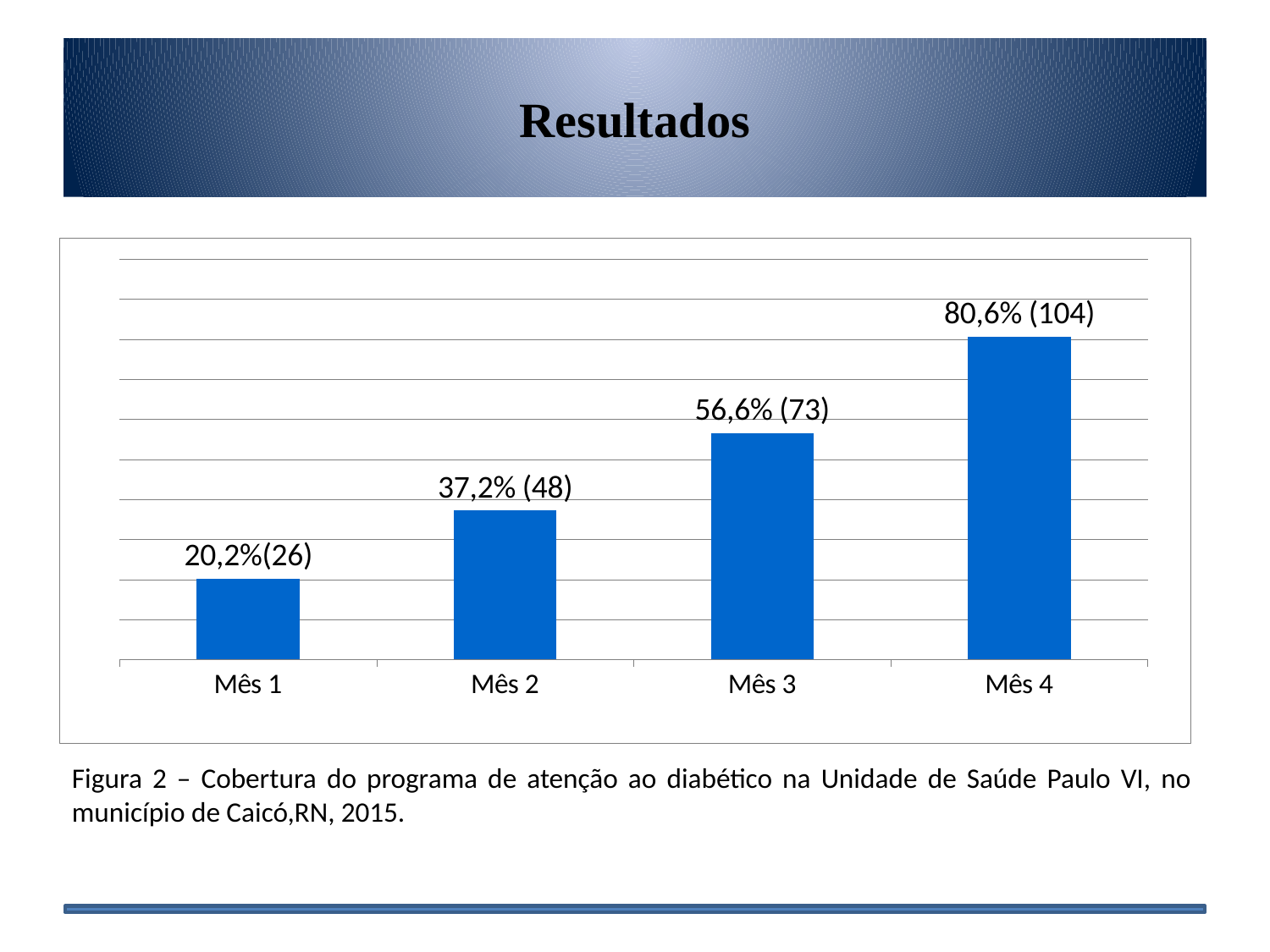
What is the difference in the number of cases (in parentheses) between Mês 4 and Mês 3? 31 Which is larger, the value for Mês 2 or the value for Mês 3? Mês 3 What percentage is shown for Mês 4? 80,6% Which month has the highest value? Mês 4 What is the data label shown for Mês 1? 20,2%(26) What is the data label shown for Mês 3? 56,6% (73) How many months (categories) are shown on the chart? 4 Which month has the lowest value? Mês 1 What is the difference in percentage between Mês 2 and Mês 1? 17,0% What kind of chart is shown on the slide? Bar chart Do the values rise or fall from Mês 1 to Mês 4? Rise How many cases (the number in parentheses) are shown for Mês 2? 48